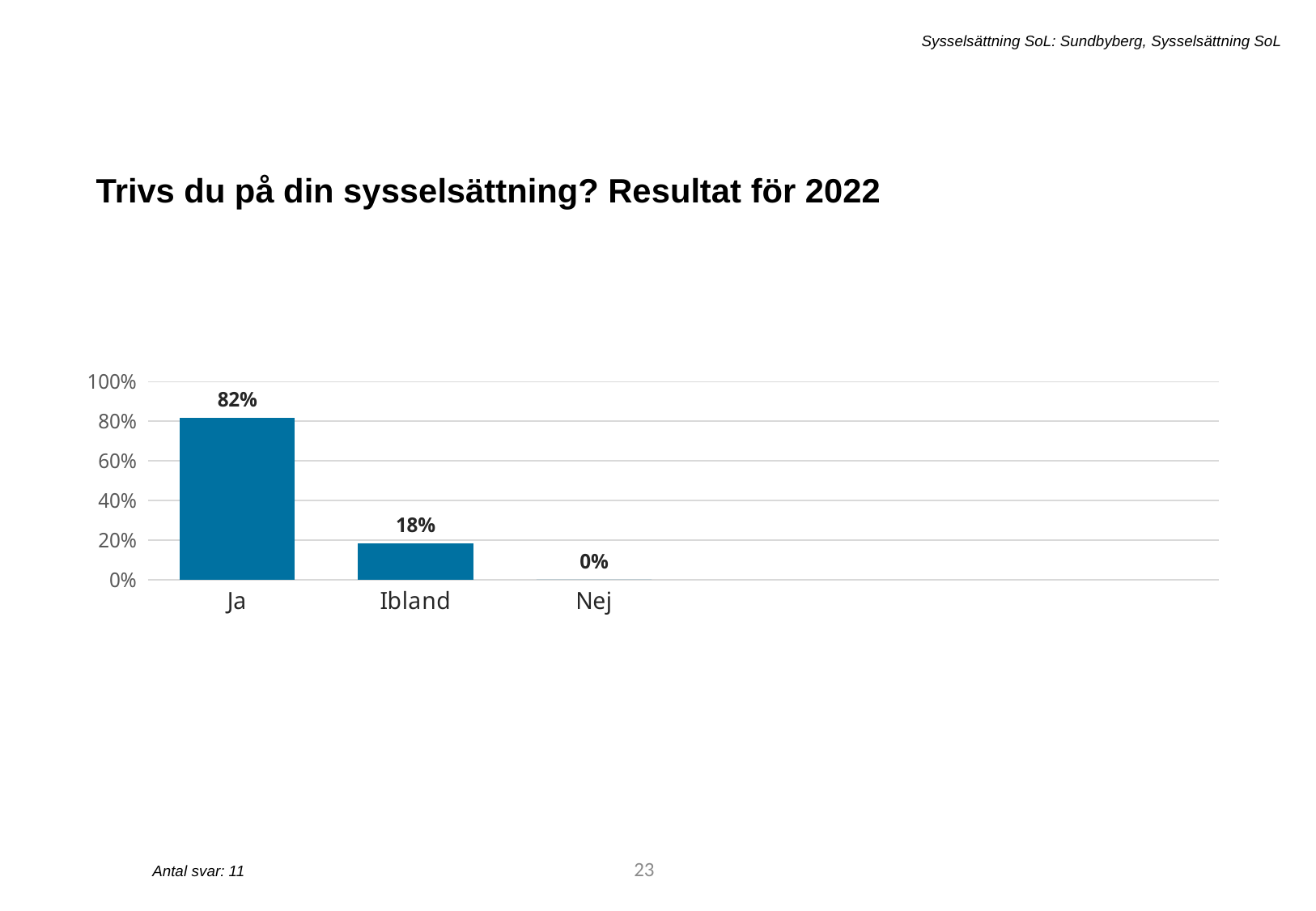
What is the difference between the values for Ja and Ibland? 64% What is the value for Nej? 0% What is the title of the slide? Trivs du på din sysselsättning? Resultat för 2022 How many categories are shown on the x axis? 3 Which category has the highest value? Ja Which category has the lowest value? Nej Which is larger, the value for Ibland or the value for Nej? Ibland What is the value for Ibland? 18% Do the values rise or fall from left to right along the x axis? fall Is the value for Ja greater or less than 60%? greater What is the value for Ja? 82% What kind of chart is shown on the slide? bar chart